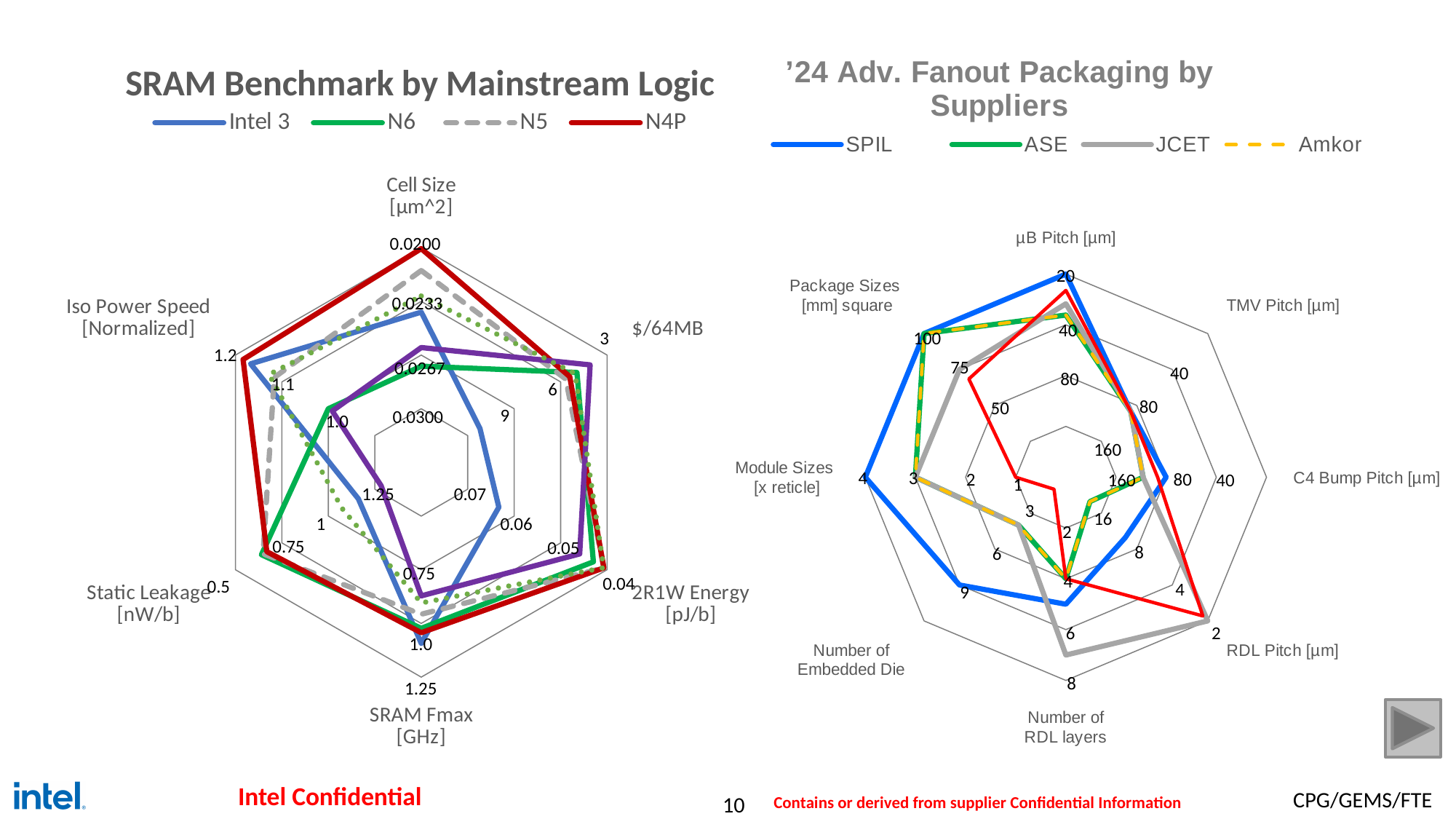
In the 'SRAM Benchmark by Mainstream Logic' chart, is the value for Intel 3 on the Iso Power Speed axis greater or less than 1.1? greater How many axes (categories) does the ''24 Adv. Fanout Packaging by Suppliers' radar chart have? 8 What kind of chart is the ''24 Adv. Fanout Packaging by Suppliers' chart on the right? radar chart How many series does the legend of the ''24 Adv. Fanout Packaging by Suppliers' chart list? 4 In the ''24 Adv. Fanout Packaging by Suppliers' chart, is the value for SPIL on the Module Sizes axis greater or less than 3? greater In the ''24 Adv. Fanout Packaging by Suppliers' chart, which series is drawn with a dashed yellow line? Amkor In the 'SRAM Benchmark by Mainstream Logic' chart, which series is drawn with a dashed grey line? N5 How many axes (categories) does the 'SRAM Benchmark by Mainstream Logic' radar chart have? 6 How many series does the legend of the 'SRAM Benchmark by Mainstream Logic' chart list? 4 In the 'SRAM Benchmark by Mainstream Logic' chart, is the value for N6 on the Iso Power Speed axis greater or less than 1.1? less What kind of chart is the 'SRAM Benchmark by Mainstream Logic' chart on the left? radar chart